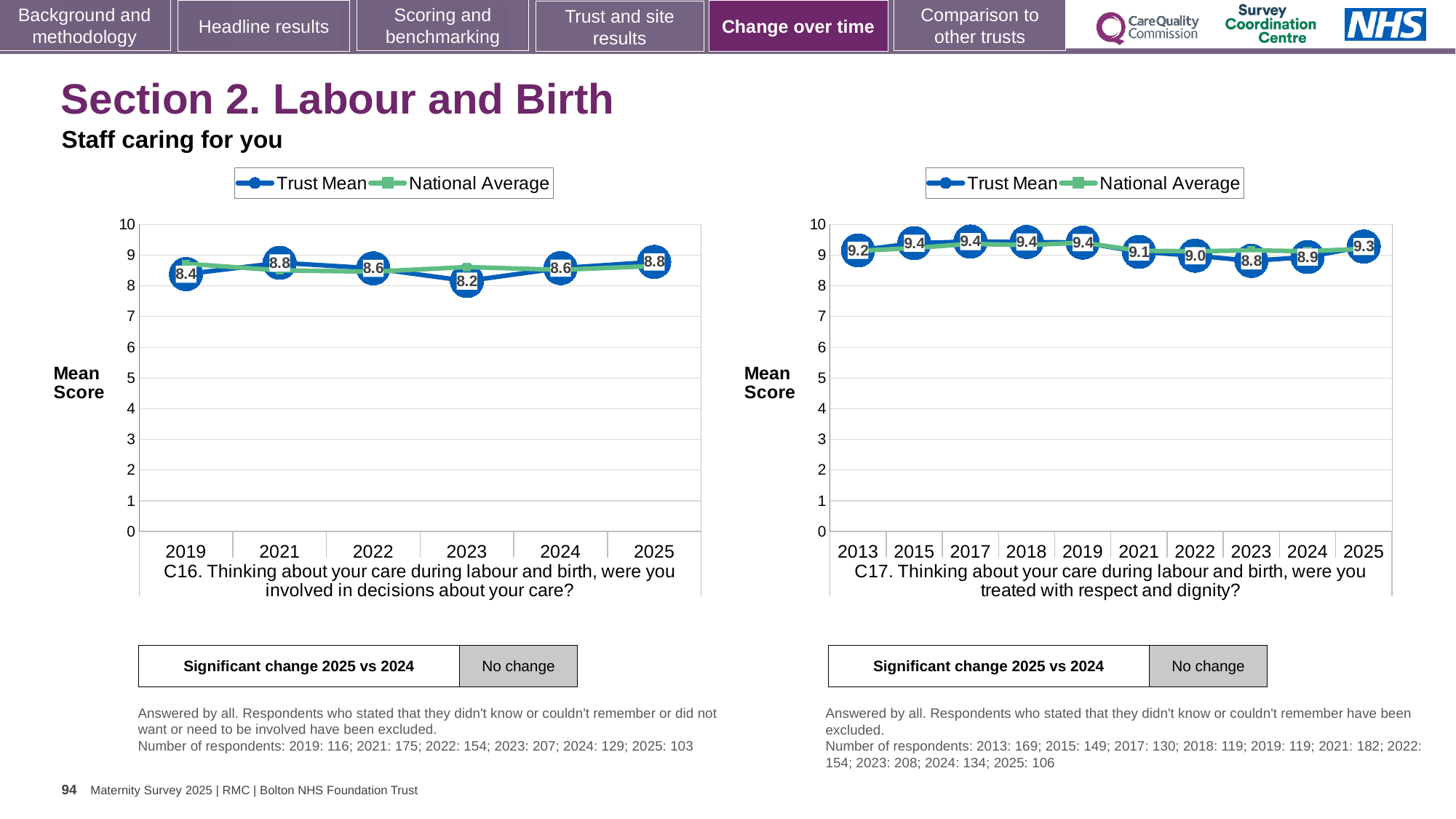
In the C17 chart on the right, what is the Trust Mean score for 2013? 9.2 What type of chart is the C16 chart on the left? Line chart In the C17 chart on the right, is the Trust Mean score higher in 2019 or in 2021? 2019 In the C16 chart on the left, what is the Trust Mean score for 2025? 8.8 How many series does the legend of the C17 chart on the right list? 2 In the C17 chart on the right, what is the Trust Mean score for 2022? 9.0 In the C16 chart on the left, what is the Trust Mean score for 2023? 8.2 In the C17 chart on the right, which year has the lowest Trust Mean score? 2023 In the C16 chart on the left, how many years are shown on the x axis? 6 In the C17 chart on the right, how many years are shown on the x axis? 10 In the C16 chart on the left, what is the difference between the Trust Mean scores for 2021 and 2023? 0.6 In the C16 chart on the left, which year has the lowest Trust Mean score? 2023